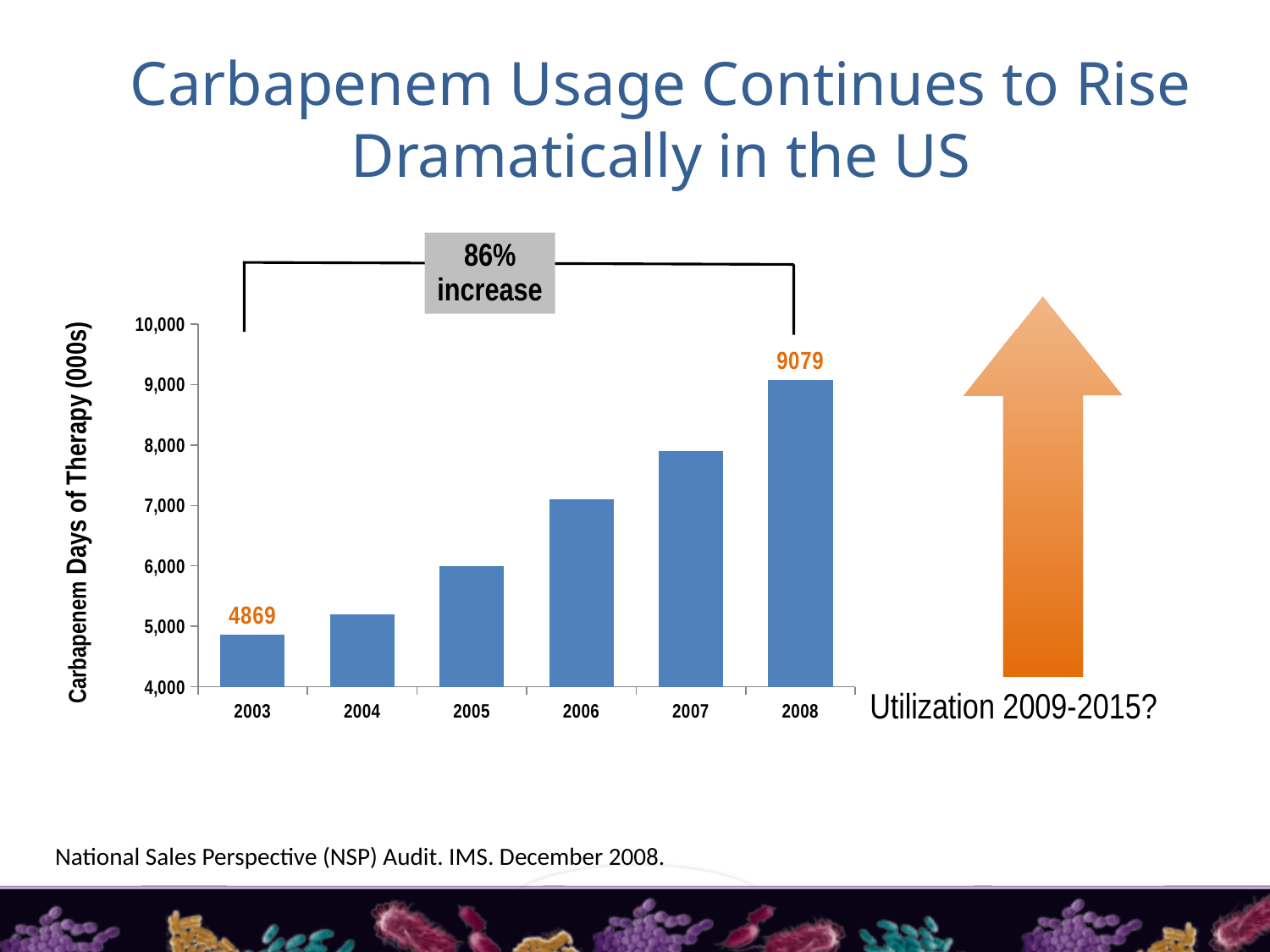
What is the value for 2008? 9079 What is the difference between the 2008 value and the 2003 value? 4210 What kind of chart is shown? Bar chart Is the value for 2006 greater or less than 8,000? less What percentage increase is annotated above the chart between 2003 and 2008? 86% increase How many years are shown on the x axis? 6 Do the values rise or fall from 2003 to 2008? Rise Which year has the lowest value? 2003 What is the value for 2003? 4869 Which is larger, the value for 2007 or the value for 2005? 2007 Which year has the highest value? 2008 Is the value for 2004 greater or less than 5,000? greater